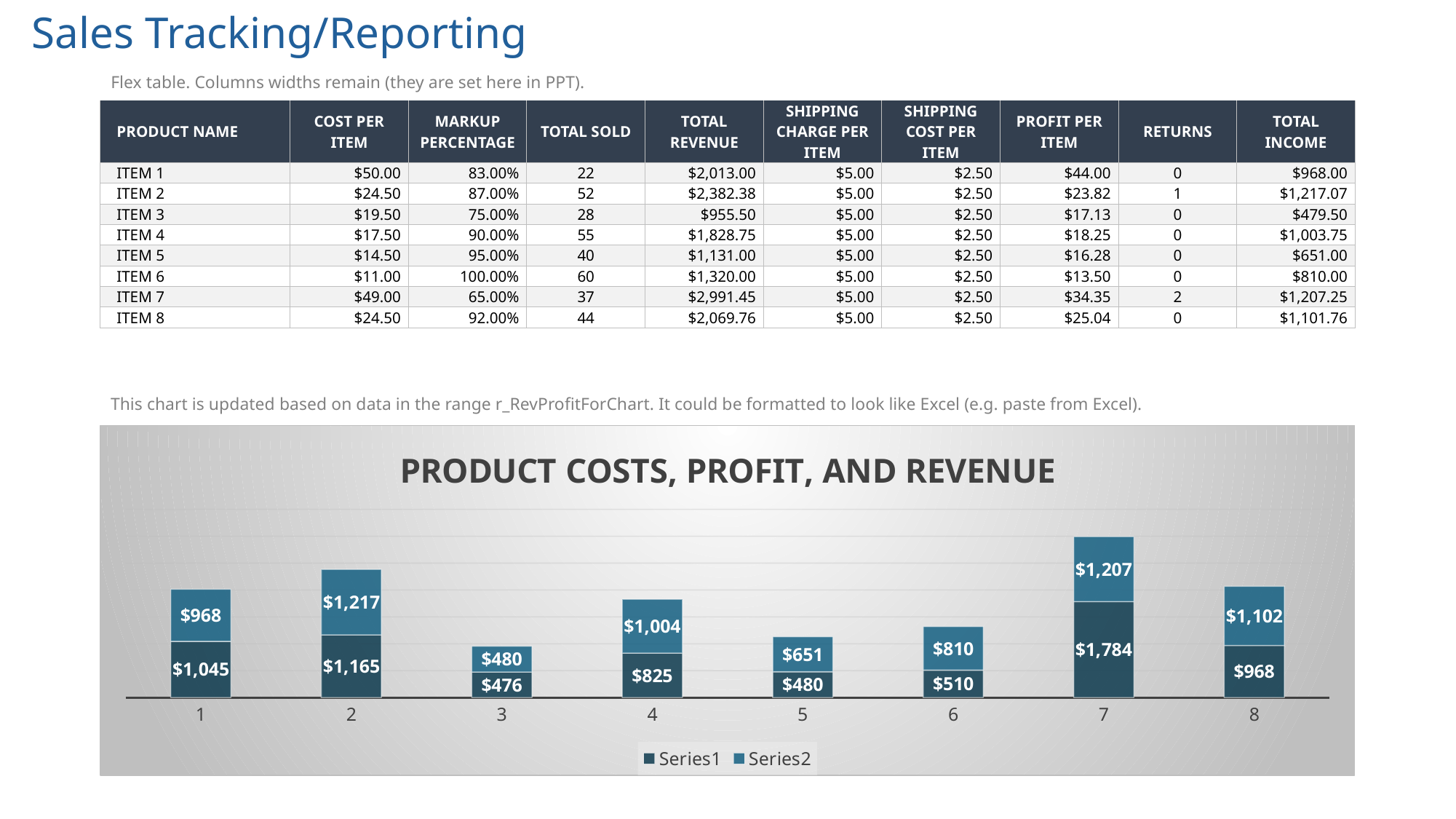
In the chart, which category has the highest Series1 value? 7 How many series does the chart legend list? 2 In the chart, what is the total of the stacked bar for category 5? $1,131 How many categories are shown on the x axis of the chart? 8 In the chart, what is the Series1 value for category 7? $1,784 In the chart, what is the Series1 value for category 3? $476 In the chart, which category has the lowest Series2 value? 3 In the chart, what is the difference between the Series2 values for category 2 and category 1? $249 In the chart, what is the Series2 value for category 4? $1,004 What type of chart is shown under the title 'PRODUCT COSTS, PROFIT, AND REVENUE'? Stacked bar chart In the chart, which is larger: the Series1 value for category 2 or the Series1 value for category 8? Series1 value for category 2 What is the title of the chart on the slide? PRODUCT COSTS, PROFIT, AND REVENUE